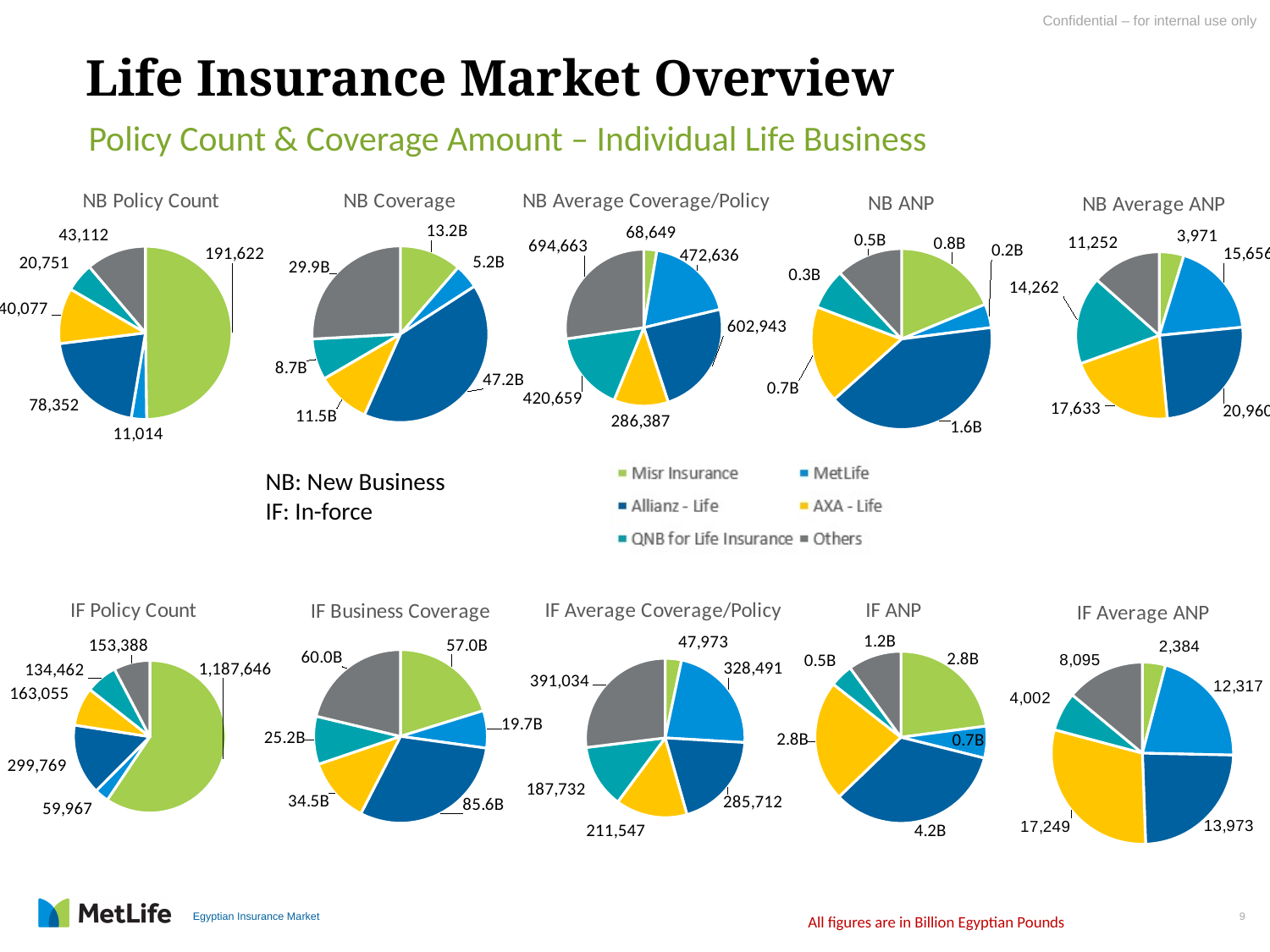
In the NB ANP chart, what is the value for MetLife? 0.2B What type of chart is the NB Coverage chart? Pie chart How many companies does the legend list? 6 In the IF ANP chart, what is the value for Allianz - Life? 4.2B In the NB Average ANP chart, which company has the highest value? Allianz - Life In the IF Average Coverage/Policy chart, what is the value for Others? 391,034 In the NB Coverage chart, what is the value for Allianz - Life? 47.2B In the IF Average ANP chart, what is the difference between AXA - Life and Allianz - Life? 3,276 In the NB Average Coverage/Policy chart, which company has the lowest value? Misr Insurance In the IF Business Coverage chart, which is larger, Others or Misr Insurance? Others In the IF Policy Count chart, what is the difference between Allianz - Life and MetLife? 239,802 In the NB Policy Count chart, what is the value for Misr Insurance? 191,622